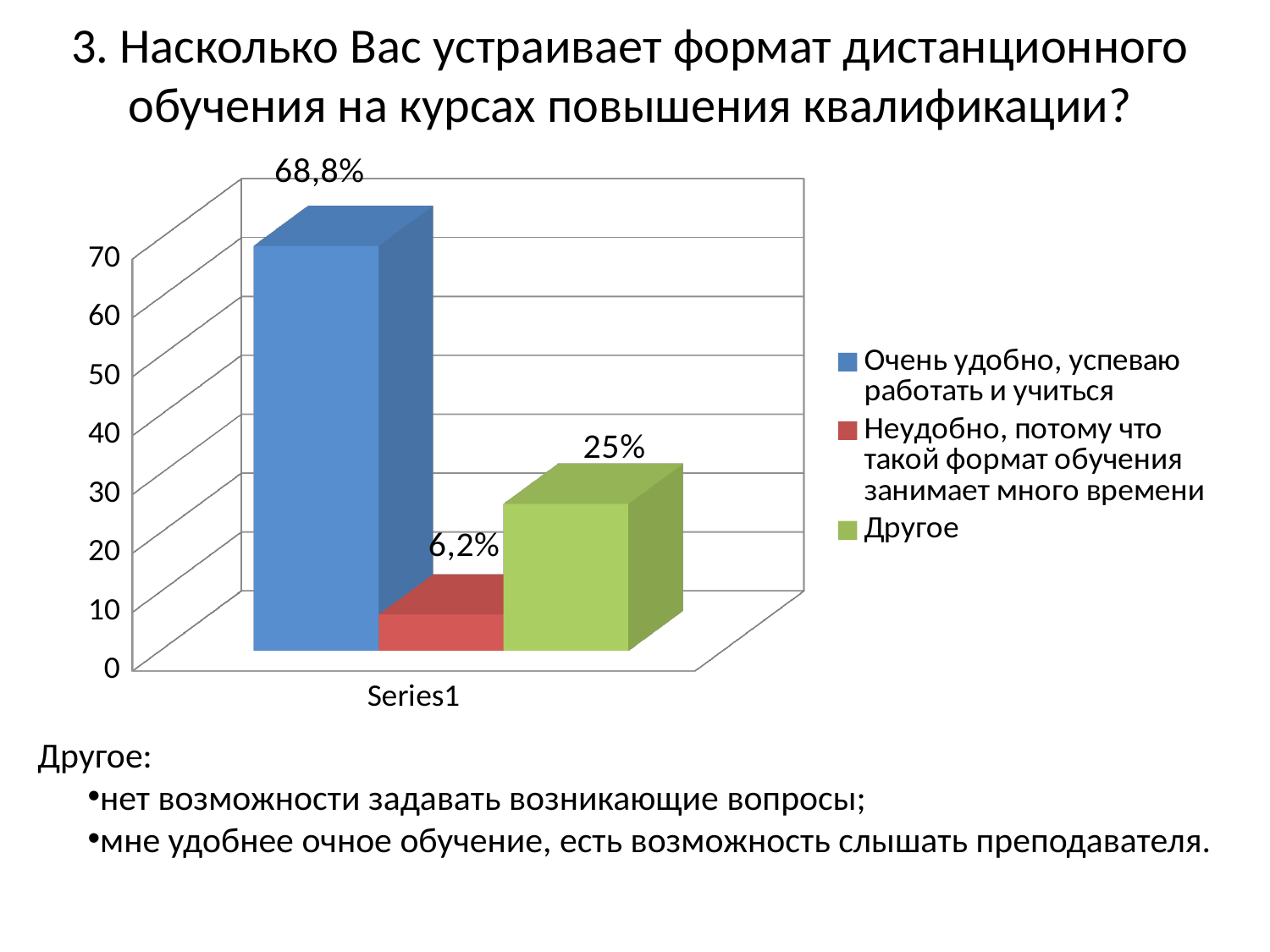
Which legend entry has the lowest value? Неудобно, потому что такой формат обучения занимает много времени What kind of chart is shown on the slide? bar chart Which legend entry has the highest value? Очень удобно, успеваю работать и учиться What colour is the bar for "Другое"? green Is the value for "Очень удобно, успеваю работать и учиться" greater or less than 60? greater How many entries does the legend list? 3 What value is shown for "Очень удобно, успеваю работать и учиться"? 68,8% What is the difference between the values for "Другое" and "Неудобно, потому что такой формат обучения занимает много времени"? 18,8% Which is larger: the value for "Другое" or the value for "Неудобно, потому что такой формат обучения занимает много времени"? Другое What value is shown for "Другое"? 25% What value is shown for "Неудобно, потому что такой формат обучения занимает много времени"? 6,2% What is the difference between the values for "Очень удобно, успеваю работать и учиться" and "Другое"? 43,8%